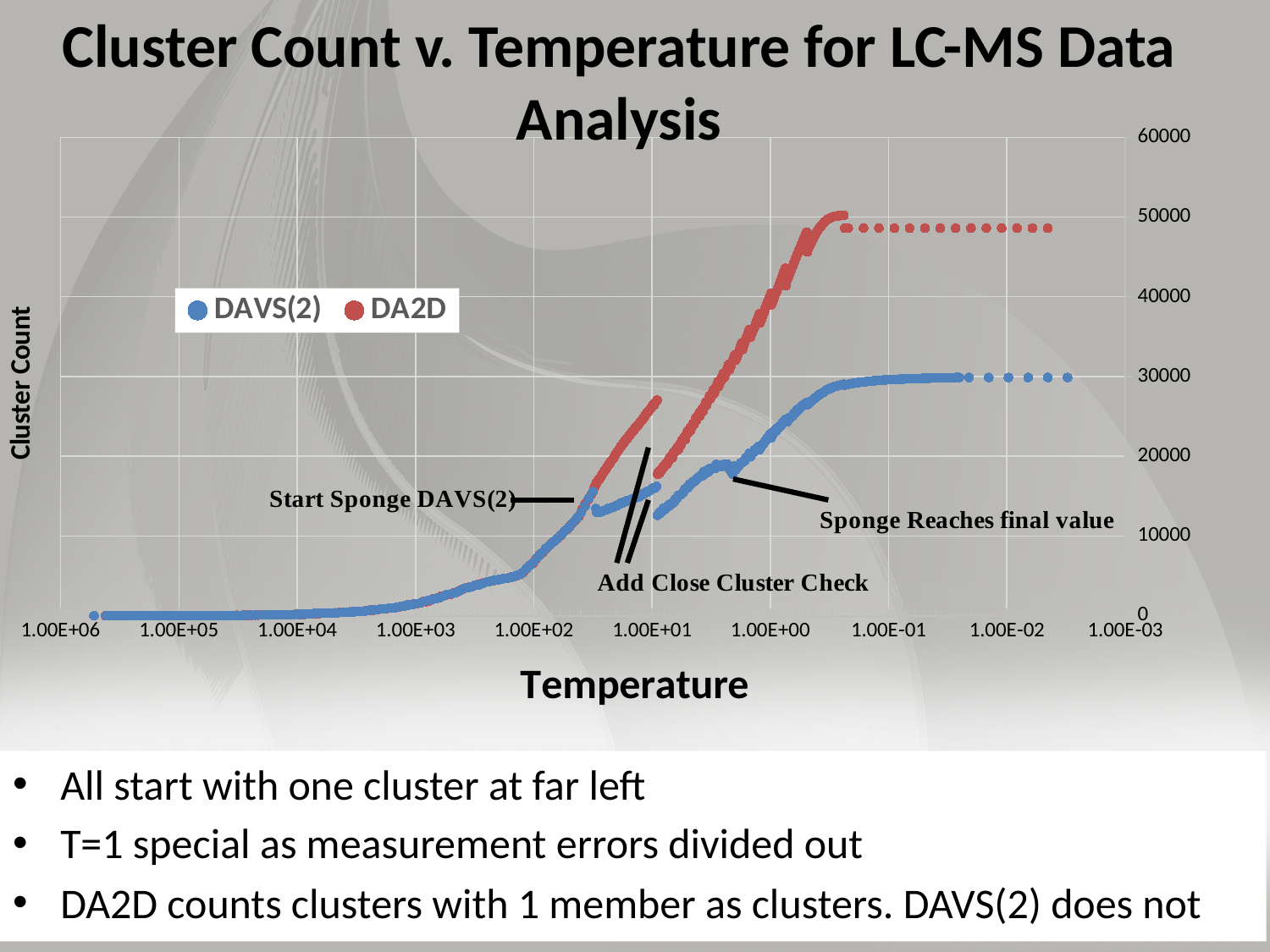
Moving from left to right along the x axis, do the cluster counts generally rise or fall? rise How many series does the legend list? 2 Is the value for DA2D at a temperature of 1.00E+00 greater or less than 20000? greater Which series reaches the higher final cluster count at the right side of the chart? DA2D Is the final plateau value for DA2D greater or less than 40000? greater Is the value for DAVS(2) at a temperature of 1.00E+02 greater or less than 10000? less What is the title of the x axis? Temperature What are the two series named in the legend? DAVS(2) and DA2D Which series levels off at the lower final cluster count? DAVS(2) What kind of chart is shown on the slide? scatter chart